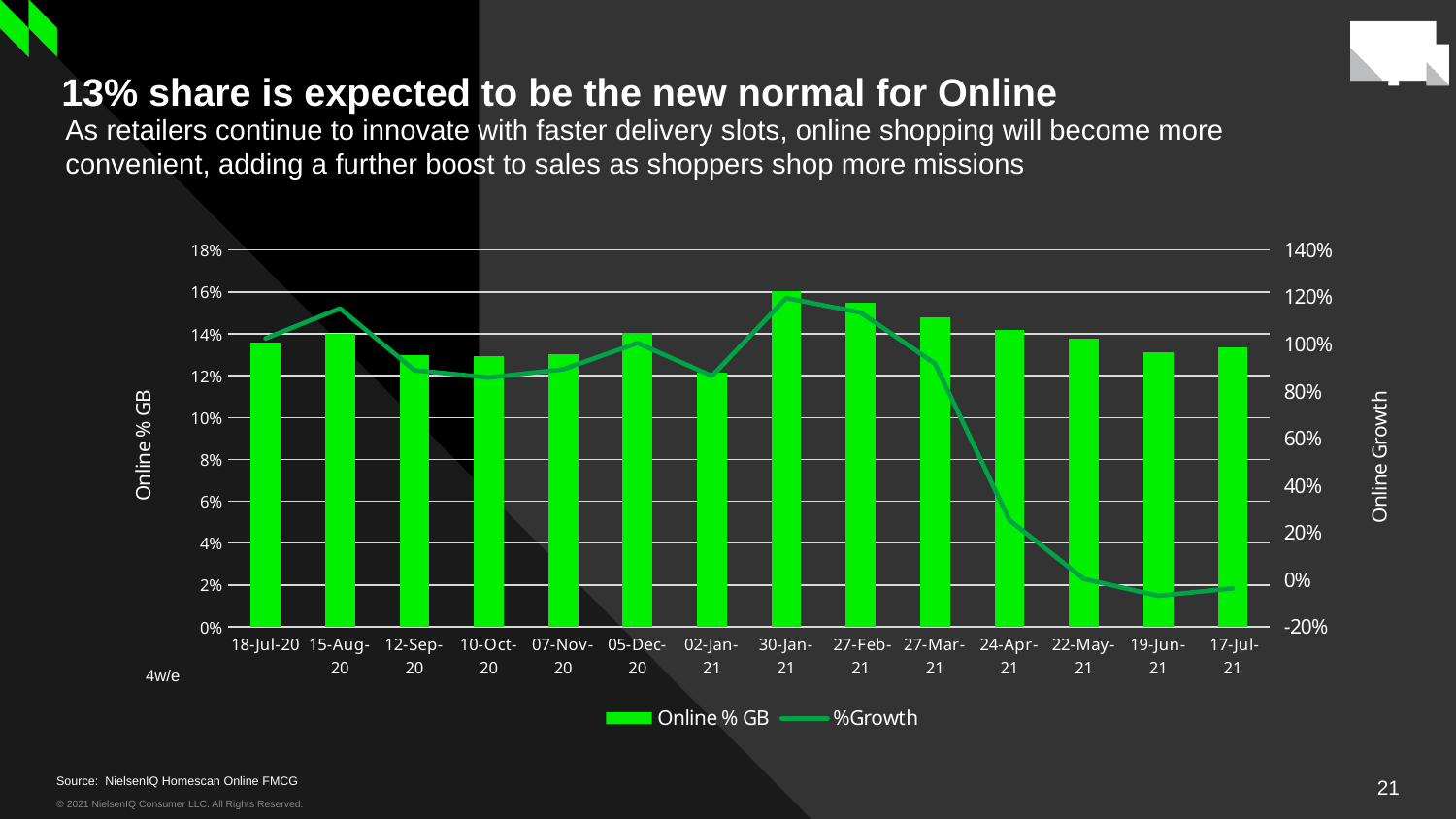
What is the title of the right vertical axis? Online Growth Which period has the lowest Online % GB bar? 02-Jan-21 Which has the larger Online % GB bar, 27-Feb-21 or 19-Jun-21? 27-Feb-21 Is the Online % GB value for 30-Jan-21 greater or less than 14%? greater Which period has the highest Online % GB bar? 30-Jan-21 How many 4w/e periods are plotted along the x axis? 14 What is the title of the left vertical axis? Online % GB How many series does the legend list? 2 Is the %Growth value for 24-Apr-21 greater or less than 40%? less Is the %Growth value for 15-Aug-20 greater or less than 100%? greater Does the %Growth line rise or fall between 27-Mar-21 and 22-May-21? fall What kind of chart is shown on the slide? Combination bar and line chart